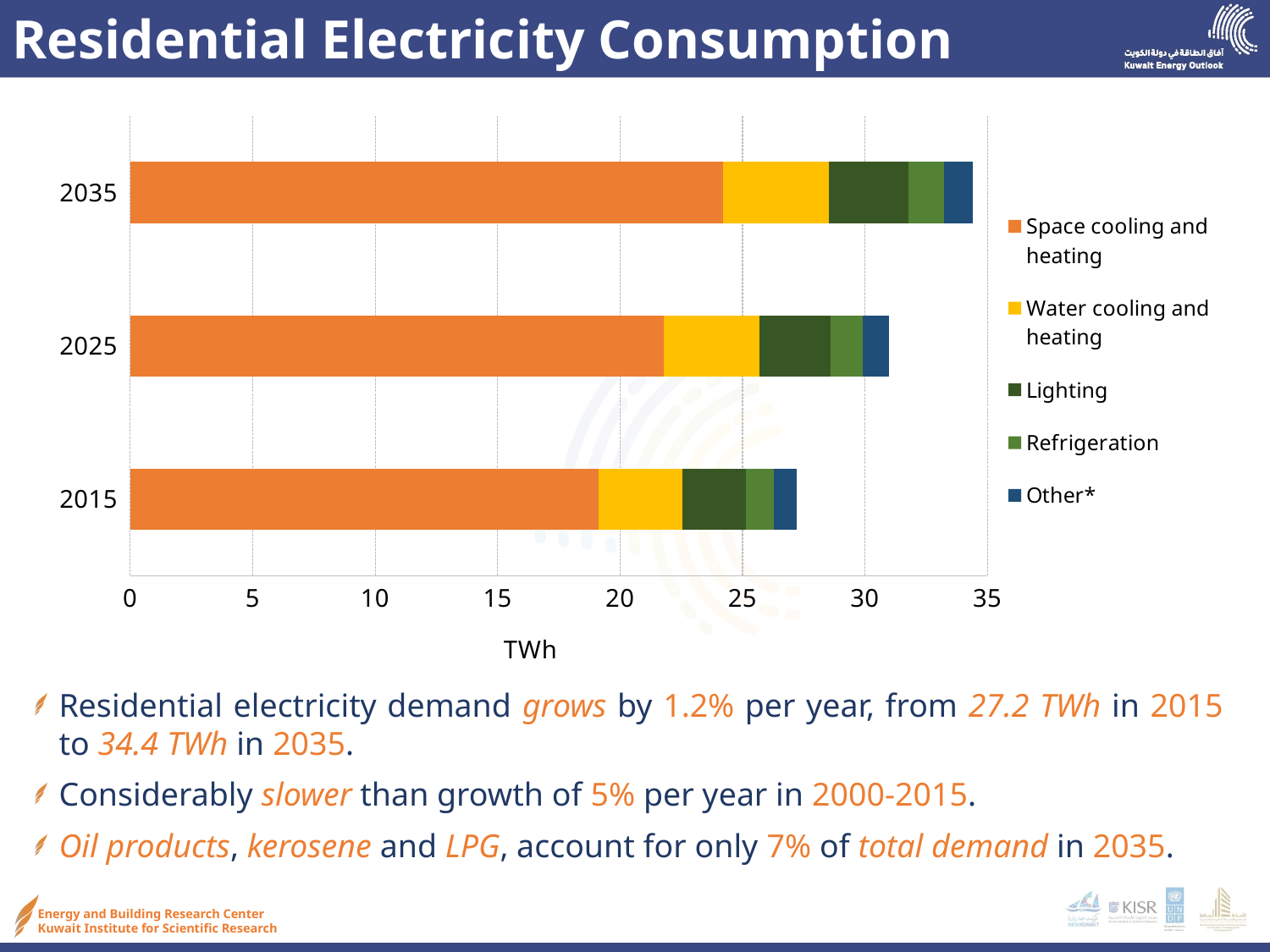
What is the total residential electricity consumption in 2035? 34.4 TWh Which series makes up the largest segment of each bar? Space cooling and heating Which year has the highest total residential electricity consumption? 2035 How many years (categories) are plotted on the chart? 3 What unit is shown on the x axis of the chart? TWh Is the Space cooling and heating segment for 2015 greater or less than 20 TWh? less Is the total bar for 2025 greater or less than 30 TWh? greater By how much does total residential electricity consumption increase from 2015 to 2035? 7.2 TWh Which year has the lowest total residential electricity consumption? 2015 What is the total residential electricity consumption in 2015? 27.2 TWh What kind of chart is shown on the slide? Stacked bar chart How many series does the chart legend list? 5